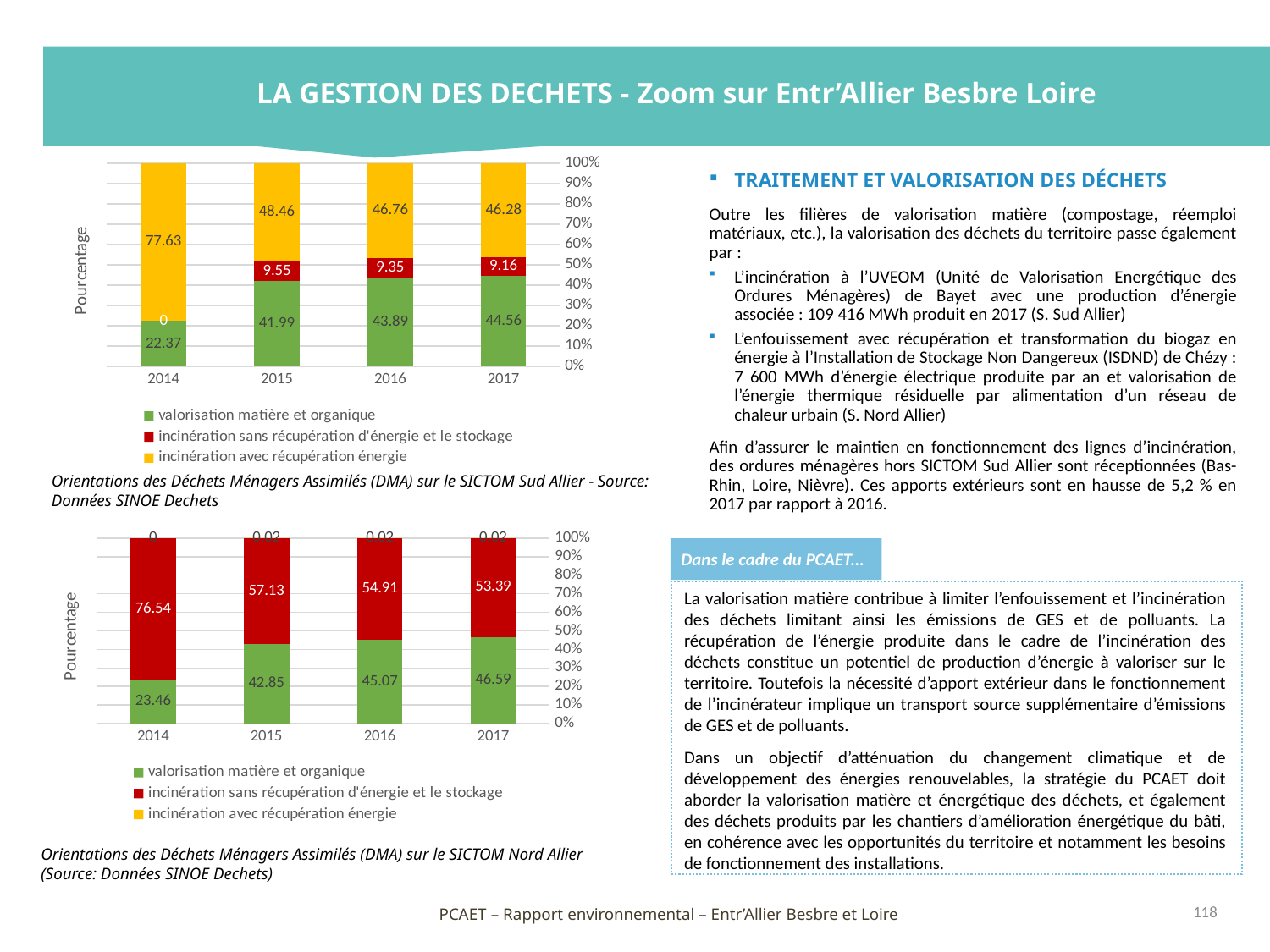
How many series does the legend of the bottom chart (SICTOM Nord Allier) list? 3 In the top chart (SICTOM Sud Allier), which year has the highest value for 'incinération avec récupération énergie'? 2014 In the top chart (SICTOM Sud Allier), does the value for 'valorisation matière et organique' rise or fall from 2014 to 2017? rise In the top chart (SICTOM Sud Allier), what is the value for 'valorisation matière et organique' in 2017? 44.56 In the bottom chart (SICTOM Nord Allier), what is the value for 'valorisation matière et organique' in 2016? 45.07 In the bottom chart (SICTOM Nord Allier), what is the value for 'incinération sans récupération d'énergie et le stockage' in 2014? 76.54 In the bottom chart (SICTOM Nord Allier), which year has the lowest value for 'incinération sans récupération d'énergie et le stockage'? 2017 In the top chart (SICTOM Sud Allier), what is the value for 'incinération sans récupération d'énergie et le stockage' in 2015? 9.55 What kind of chart is the top chart (SICTOM Sud Allier)? stacked bar chart In the top chart (SICTOM Sud Allier), what is the value for 'incinération avec récupération énergie' in 2014? 77.63 In the top chart (SICTOM Sud Allier), what is the difference between the 'valorisation matière et organique' values for 2017 and 2014? 22.19 In the bottom chart (SICTOM Nord Allier), which is larger in 2015: 'valorisation matière et organique' or 'incinération sans récupération d'énergie et le stockage'? incinération sans récupération d'énergie et le stockage